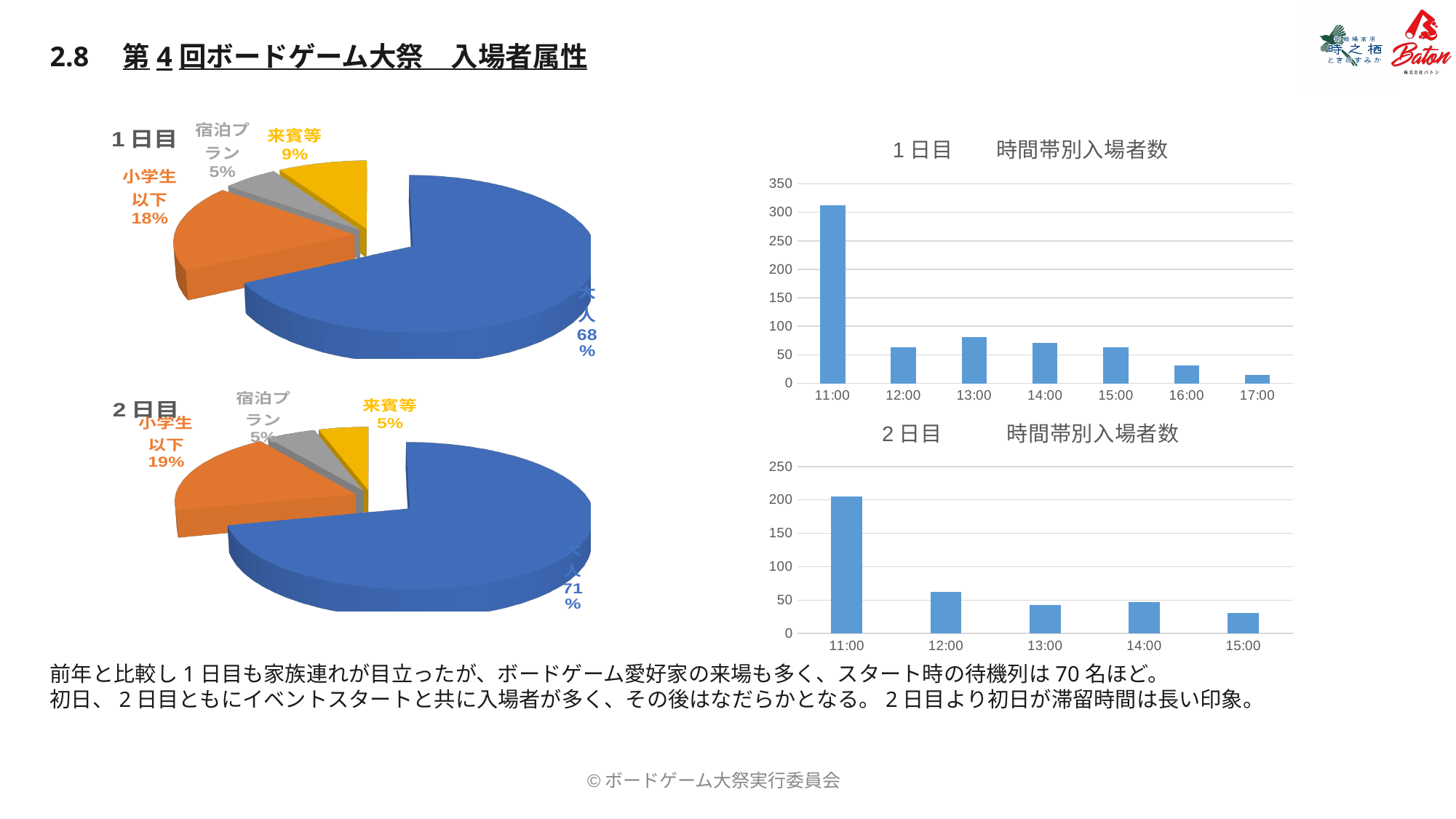
In the 1日目 時間帯別入場者数 chart, how many time slots are shown on the x axis? 7 In the 1日目 pie chart, what is the difference in percentage points between 大人 and 小学生以下? 50 In the 1日目 時間帯別入場者数 chart, is the value for 11:00 greater or less than 300? greater In the 2日目 pie chart, what share is labelled for 小学生以下? 19% In the 2日目 時間帯別入場者数 chart, how many time slots are shown on the x axis? 5 Is the 来賓等 share larger in the 1日目 pie chart or the 2日目 pie chart? 1日目 What kind of chart is the 2日目 時間帯別入場者数 chart? bar chart In the 1日目 pie chart, what share is labelled for 来賓等? 9% In the 2日目 pie chart, which category has the largest share? 大人 In the 1日目 pie chart, which category has the smallest share? 宿泊プラン In the 1日目 pie chart, what share is labelled for 大人? 68%